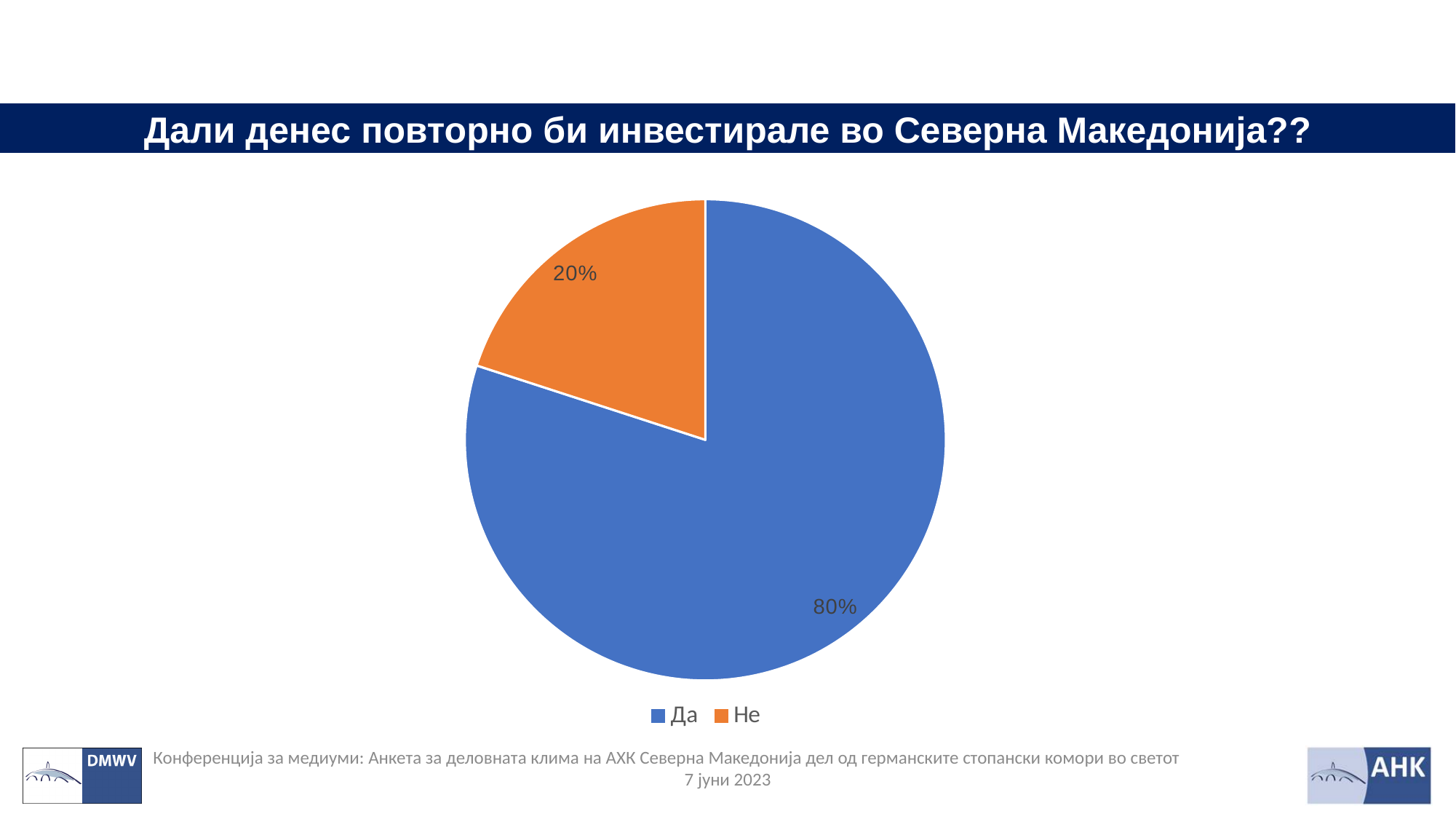
What kind of chart is shown on the slide? Pie chart What is the title of the chart on the slide? Дали денес повторно би инвестирале во Северна Македонија?? What is the difference in percentage points between the "Да" and "Не" slices? 60 percentage points Which category has the largest slice of the pie? Да What share of the pie does the "Не" slice represent? 20% How many slices does the pie chart have? 2 Is the share for "Не" greater or less than 50%? less Which category has the smallest slice of the pie? Не What share of the pie does the "Да" slice represent? 80% How many entries does the legend list? 2 Which slice is larger, "Да" or "Не"? Да What colour is the "Не" slice? Orange